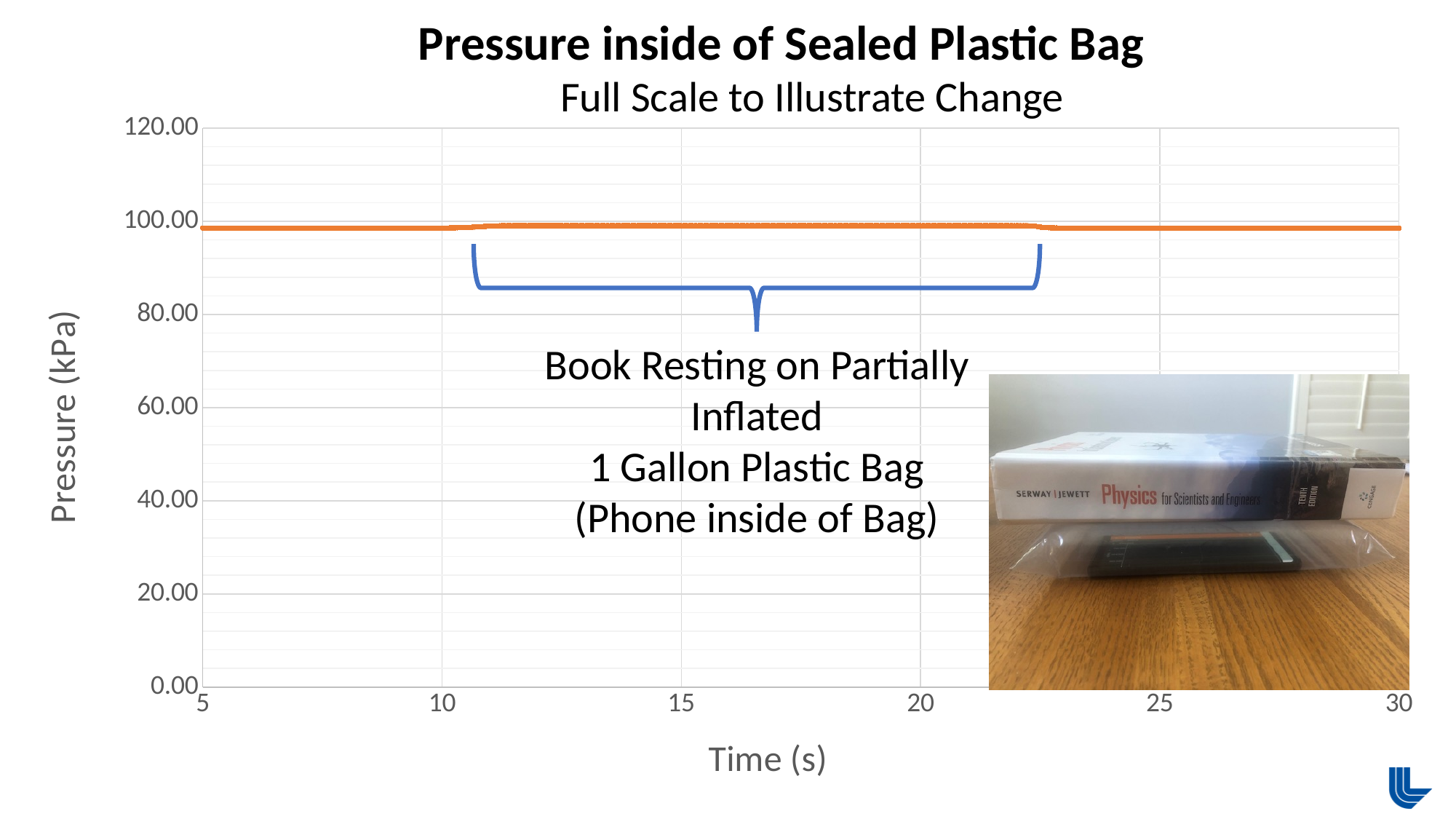
Is the pressure value at 7 s greater or less than 60? greater What is the title of the chart? Pressure inside of Sealed Plastic Bag What is the lowest time value shown on the x axis? 5 What is the highest value shown on the y axis? 120.00 Is the pressure value at 25 s greater or less than 120? less What kind of chart is shown on the slide? line chart Is the pressure value at 15 s greater or less than 80? greater Does the plotted pressure line rise, fall, or stay roughly flat across the time range? roughly flat